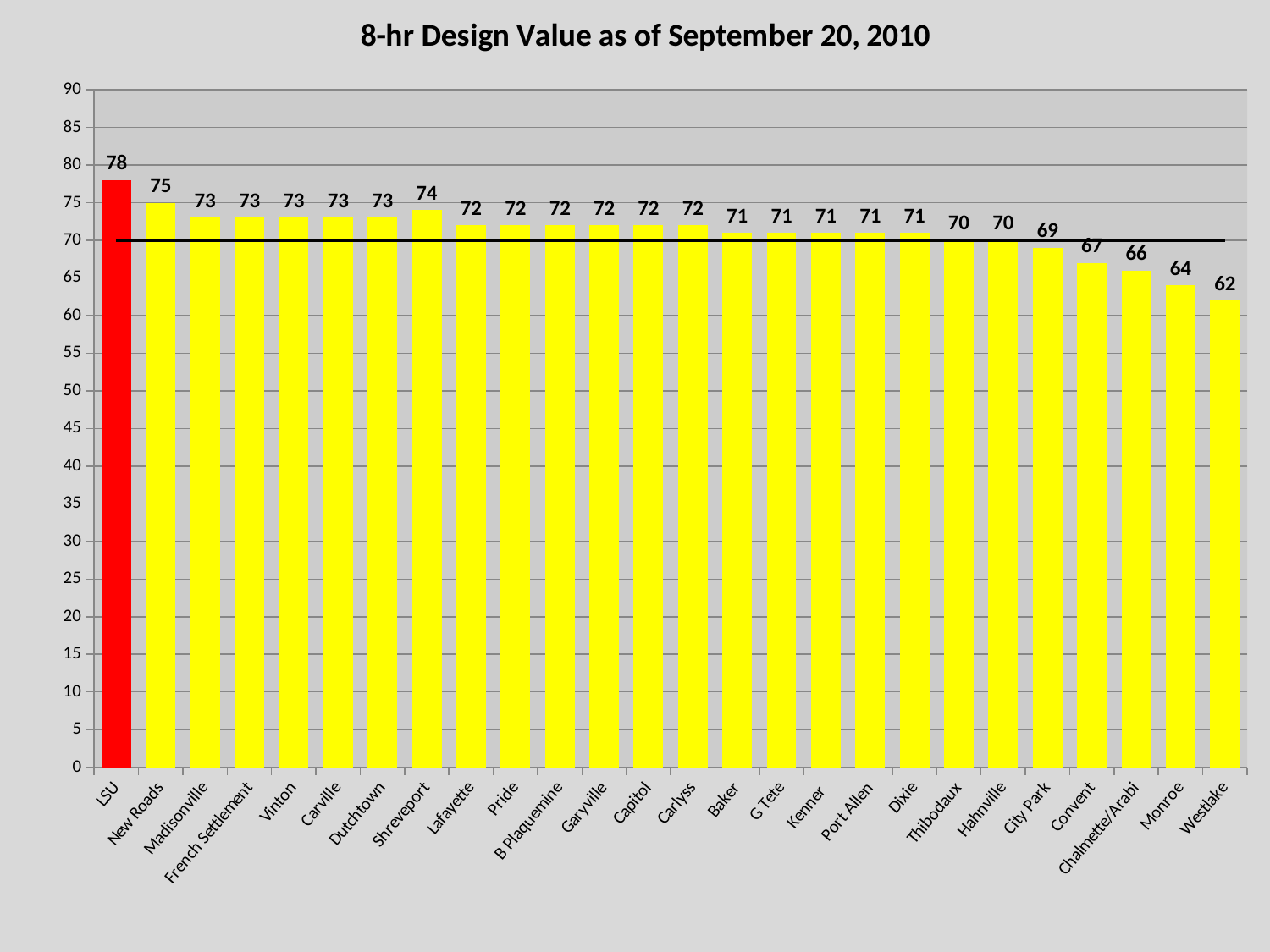
What is the 8-hr design value for LSU? 78 What is the title of the chart? 8-hr Design Value as of September 20, 2010 What is the difference between the 8-hr design values for New Roads and Monroe? 11 What kind of chart is shown on the slide? Bar chart What is the 8-hr design value for Shreveport? 74 What is the 8-hr design value for City Park? 69 Which site has the highest 8-hr design value? LSU What is the difference between the 8-hr design values for LSU and Westlake? 16 Which has a higher 8-hr design value, Shreveport or Convent? Shreveport Which site has the lowest 8-hr design value? Westlake What is the 8-hr design value for Westlake? 62 How many sites are shown on the chart? 26